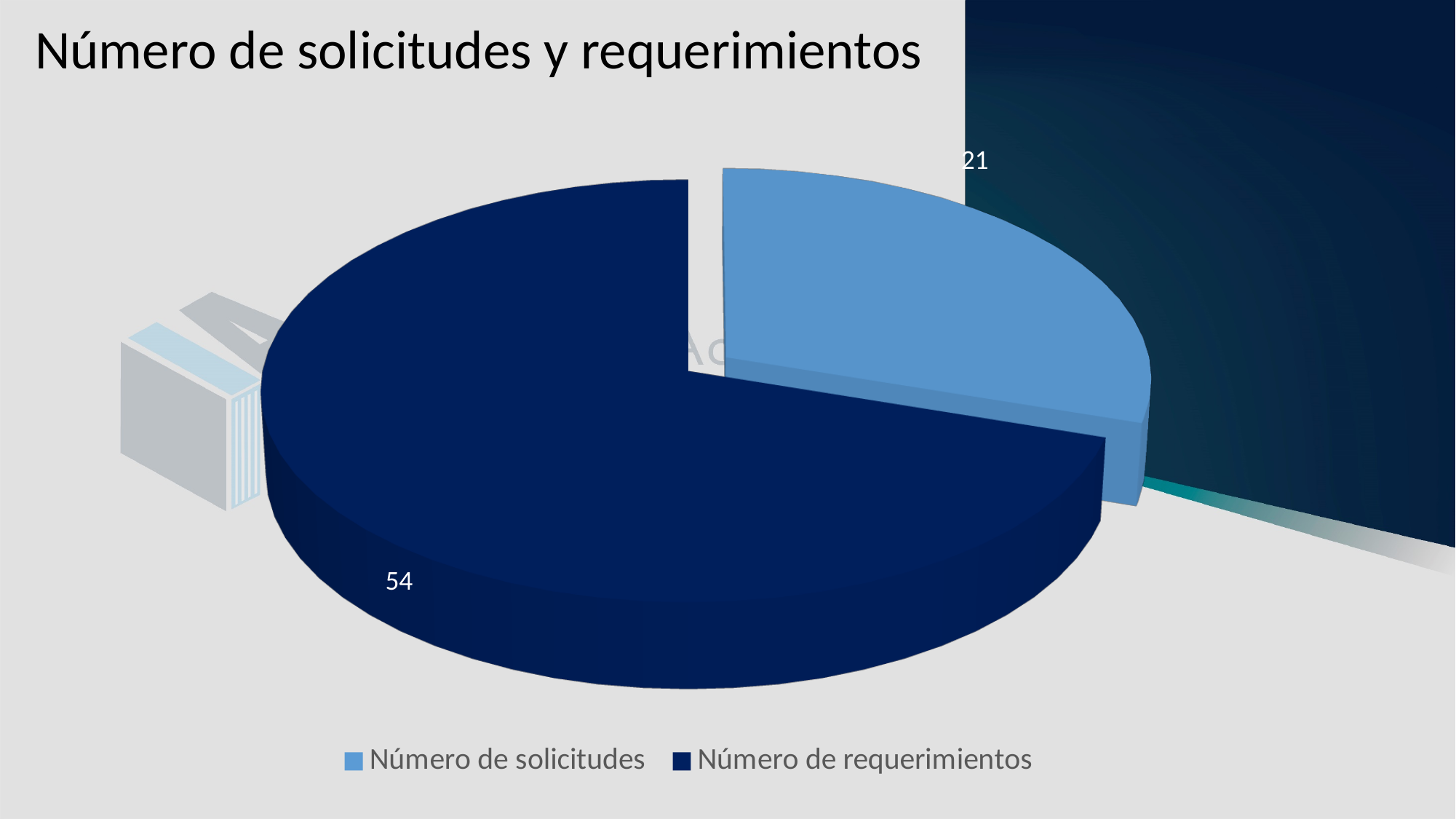
What is the total of the two values shown in the pie chart? 75 What kind of chart is shown on the slide? Pie chart How many entries does the legend list? 2 Which category has the smallest slice of the pie? Número de solicitudes What is the value for Número de requerimientos? 54 Which category has the largest slice of the pie? Número de requerimientos How many slices does the pie chart have? 2 Which is larger, Número de solicitudes or Número de requerimientos? Número de requerimientos What is the difference between Número de requerimientos and Número de solicitudes? 33 What is the value for Número de solicitudes? 21 What is the title of the chart? Número de solicitudes y requerimientos What share of the total does Número de requerimientos represent? 72%